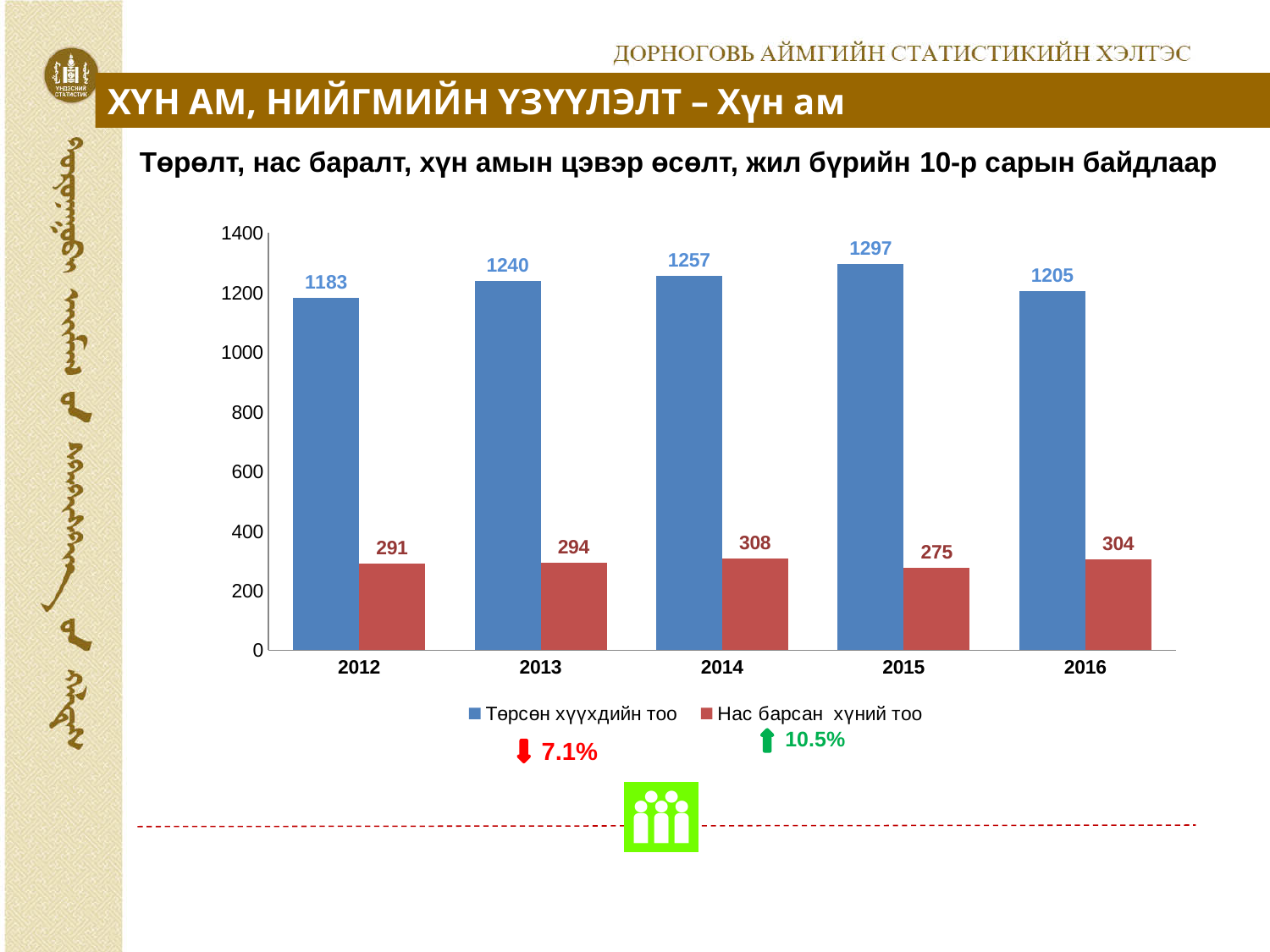
In which year is Төрсөн хүүхдийн тоо highest? 2015 What is the difference between Төрсөн хүүхдийн тоо in 2015 and in 2016? 92 What is the value for Төрсөн хүүхдийн тоо in 2012? 1183 How many series does the legend list? 2 In which year is Нас барсан хүний тоо lowest? 2015 Does Төрсөн хүүхдийн тоо rise or fall from 2012 to 2015? rise What is the value for Нас барсан хүний тоо in 2014? 308 What is the value for Төрсөн хүүхдийн тоо in 2015? 1297 Is the value for Төрсөн хүүхдийн тоо in 2013 greater or less than 1200? greater Which is larger: Нас барсан хүний тоо in 2014 or in 2016? 2014 How many years are shown on the x axis? 5 What kind of chart is shown on the slide? bar chart